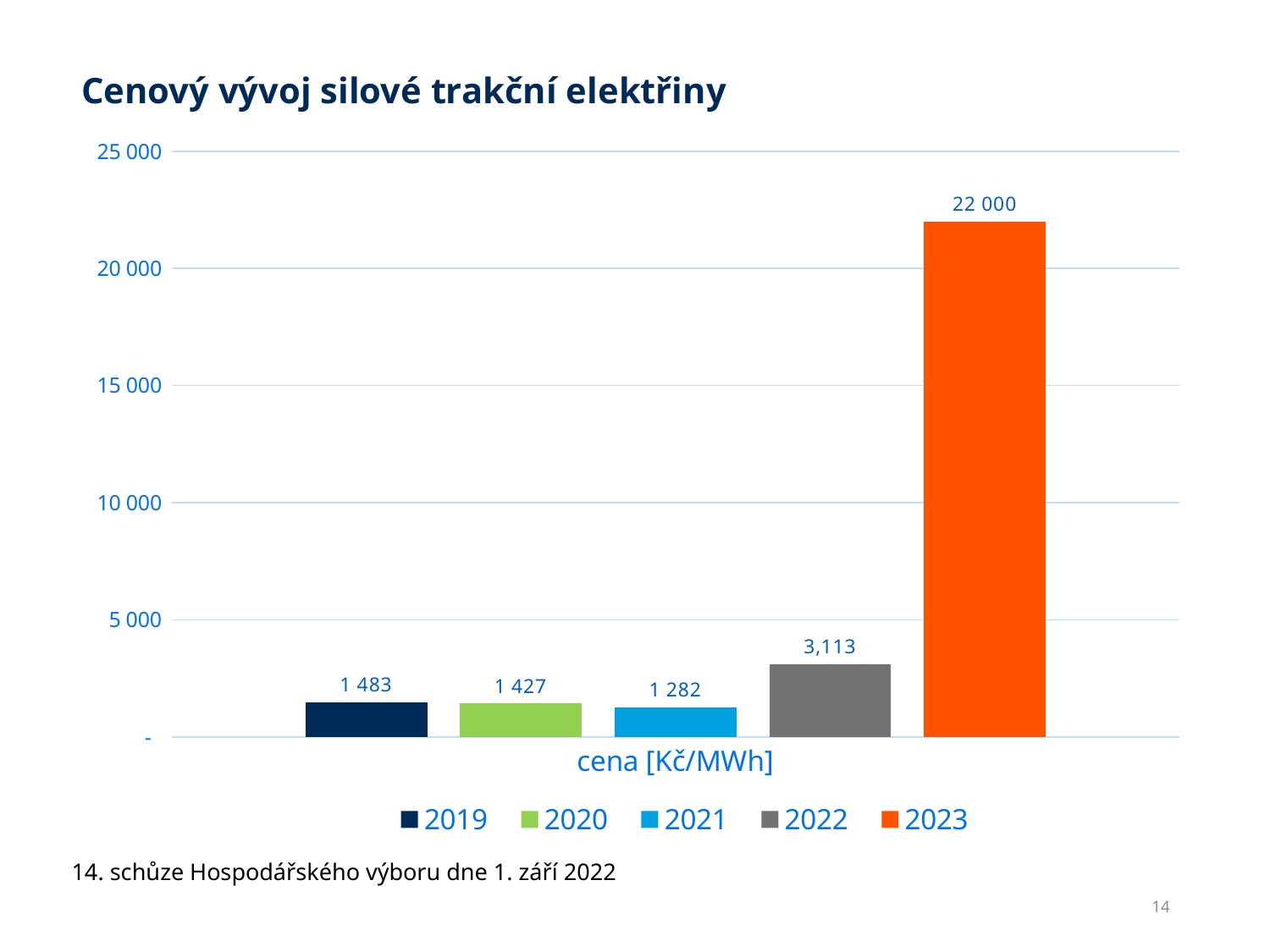
What is the value for 2023 in the chart? 22 000 What kind of chart is shown on the slide? bar chart Which is larger, the value for 2020 or the value for 2022? 2022 Is the value for 2023 greater or less than 20 000? greater What is the difference between the values for 2019 and 2020? 56 Which year has the lowest value in the chart? 2021 Which year has the highest value in the chart? 2023 What is the value for 2022 in the chart? 3,113 What is the value for 2021 in the chart? 1 282 What is the title of the chart? Cenový vývoj silové trakční elektřiny What is the value for 2019 in the chart? 1 483 How many series does the legend list? 5